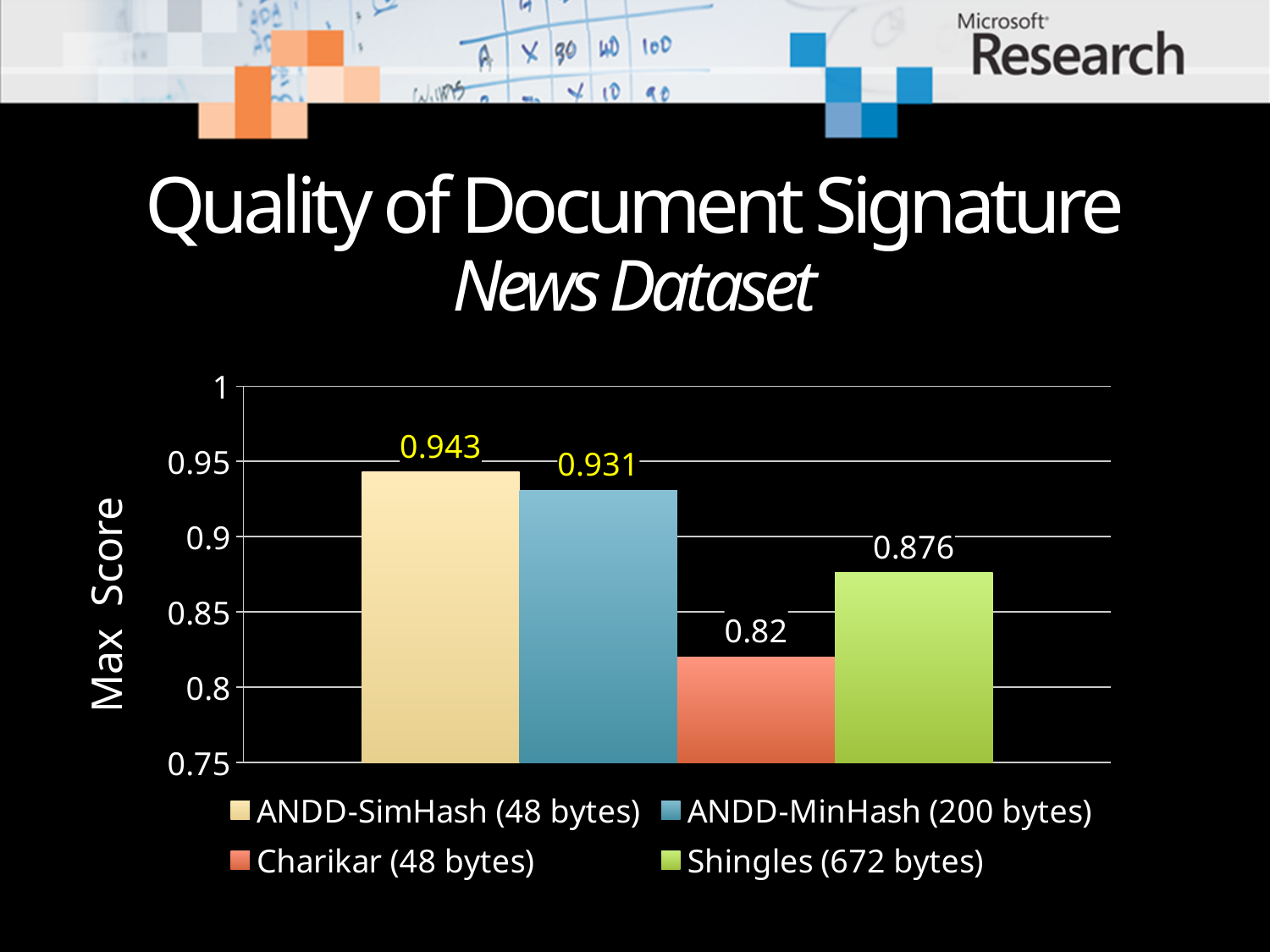
What kind of chart is shown on the slide? bar chart What is the Max Score for ANDD-SimHash (48 bytes)? 0.943 Which method has the highest Max Score? ANDD-SimHash (48 bytes) What is the Max Score for Charikar (48 bytes)? 0.82 What is the label of the vertical axis? Max Score How many series does the legend list? 4 What is the difference between the Max Score of Shingles (672 bytes) and Charikar (48 bytes)? 0.056 What is the Max Score for Shingles (672 bytes)? 0.876 Which has a higher Max Score, ANDD-MinHash (200 bytes) or Shingles (672 bytes)? ANDD-MinHash (200 bytes) What is the difference between the Max Score of ANDD-SimHash (48 bytes) and ANDD-MinHash (200 bytes)? 0.012 Is the Max Score for Charikar (48 bytes) greater or less than 0.85? less Which method has the lowest Max Score? Charikar (48 bytes)